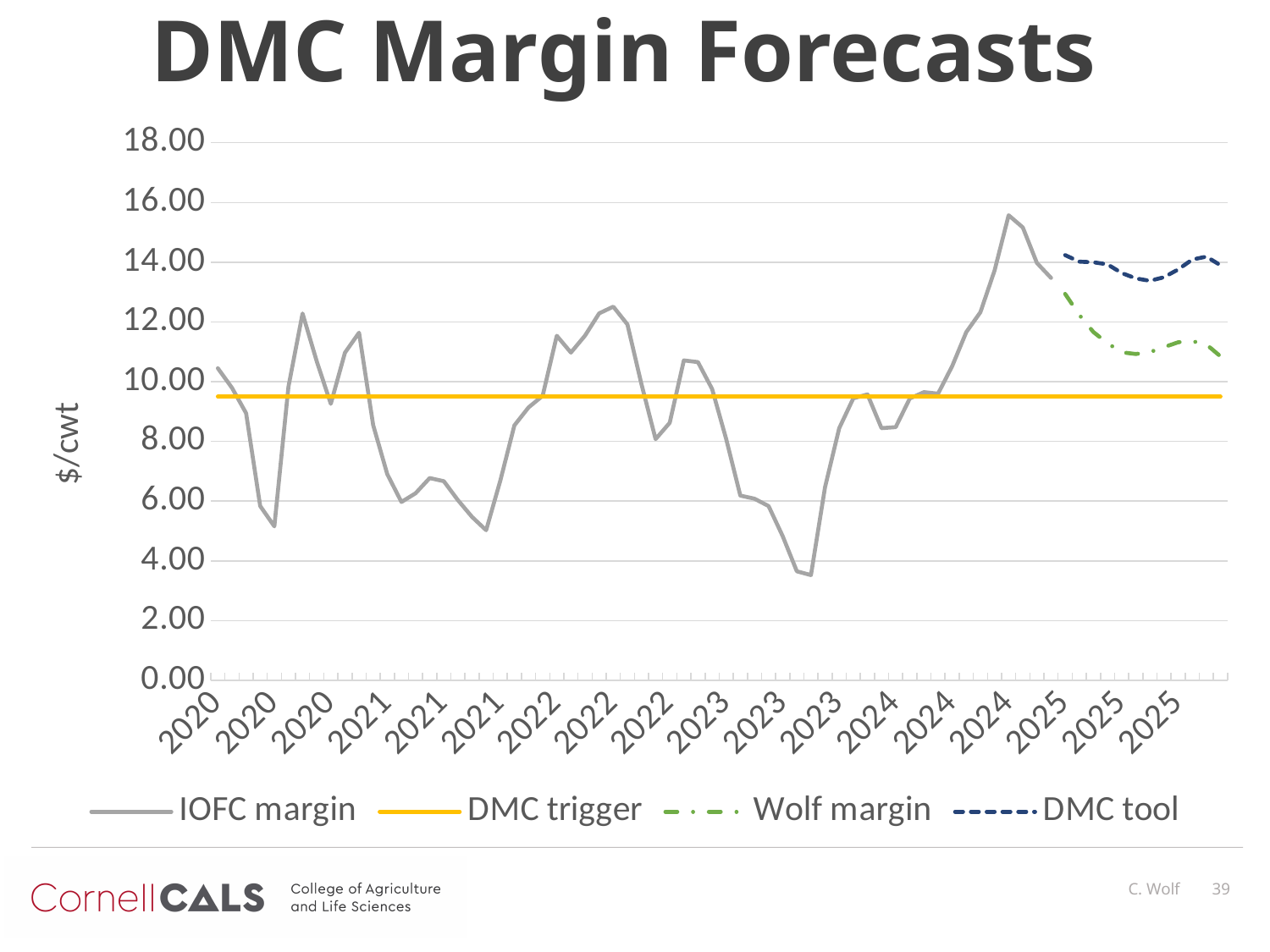
Is the DMC tool forecast line in 2025 greater or less than 12.00? greater What is the title of the chart? DMC Margin Forecasts What kind of chart is shown on the slide? Line chart Is the DMC trigger line greater or less than 8.00? greater Is the DMC trigger line greater or less than 10.00? less Does the Wolf margin forecast line generally rise or fall across 2025? Fall In the 2025 forecast period, which series is higher, DMC tool or Wolf margin? DMC tool What is the label on the vertical axis? $/cwt How many series does the legend list? 4